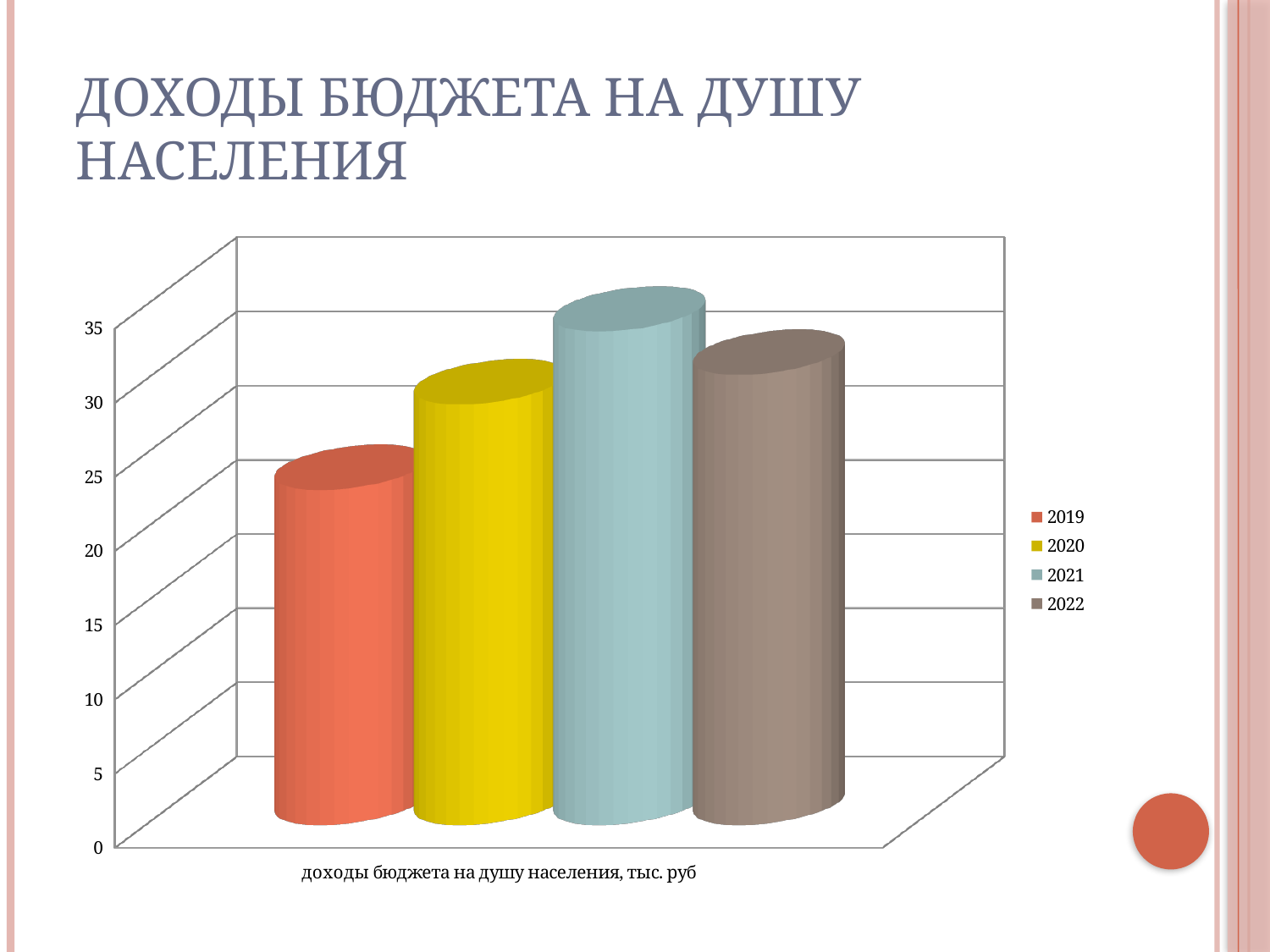
Do the values rise or fall from 2019 to 2021? rise Which year has the lowest value for доходы бюджета на душу населения? 2019 Is the value for 2019 greater or less than 20? greater How many series does the legend list? 4 Is the value for 2021 greater or less than 30? greater What kind of chart is shown on the slide? bar chart Is the value for 2022 greater or less than 25? greater Which is larger, the value for 2019 or the value for 2020? 2020 Which year has the highest value for доходы бюджета на душу населения? 2021 What is the title of the chart on the slide? ДОХОДЫ БЮДЖЕТА НА ДУШУ НАСЕЛЕНИЯ Which is larger, the value for 2021 or the value for 2022? 2021